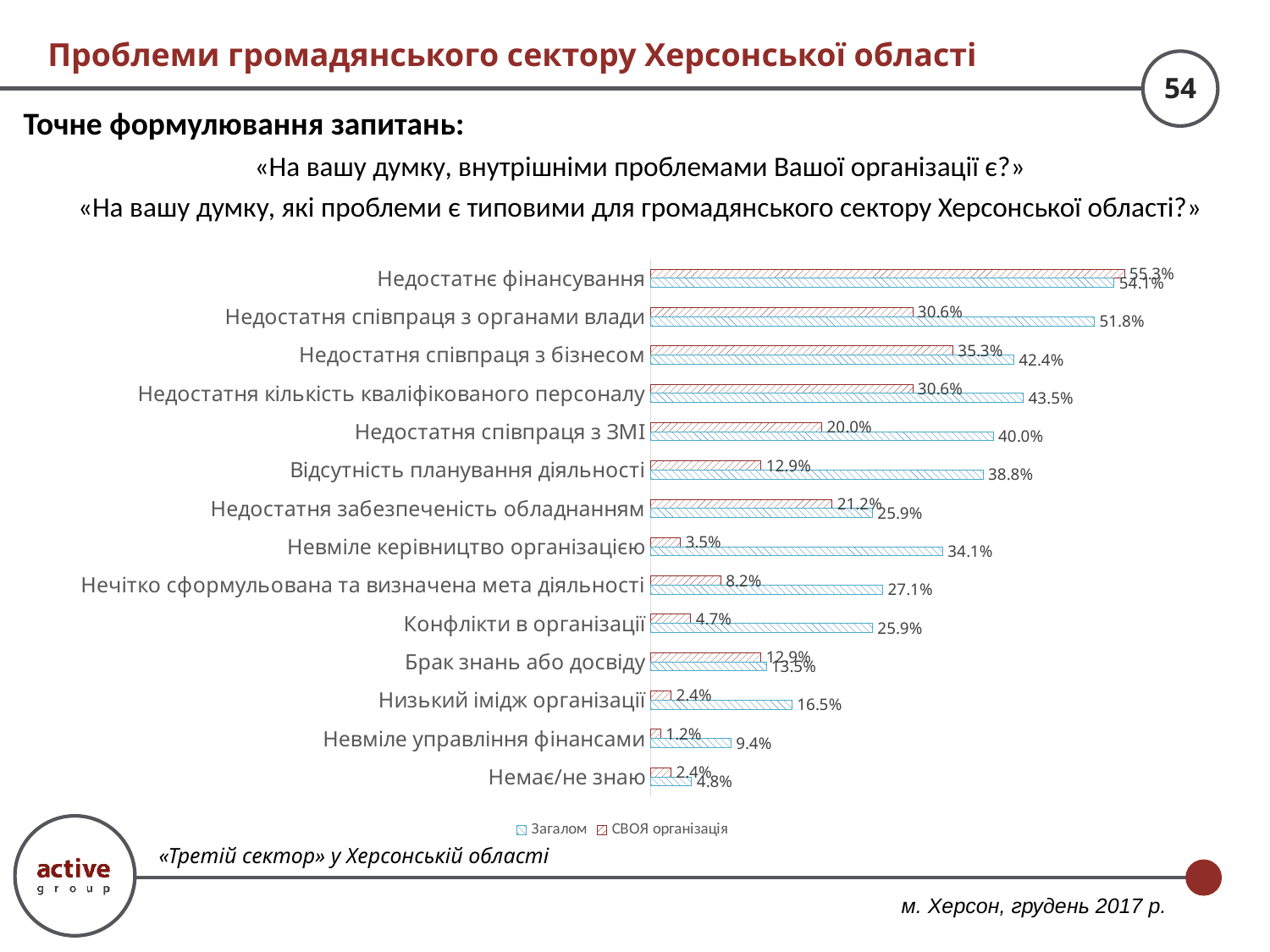
What is the difference between the 'Загалом' and 'СВОЯ організація' values for 'Недостатня співпраця з ЗМІ'? 20.0% What are the two series named in the chart legend? Загалом and СВОЯ організація What type of chart is shown on the slide? bar chart Which category has the lowest value in the 'Загалом' series? Немає/не знаю How many series does the chart legend list? 2 Which category has the highest value in the 'СВОЯ організація' series? Недостатнє фінансування What is the value of the 'Загалом' series for 'Невміле керівництво організацією'? 34.1% What is the value of the 'СВОЯ організація' series for 'Недостатня співпраця з бізнесом'? 35.3% For 'Відсутність планування діяльності', which series has the larger value: 'Загалом' or 'СВОЯ організація'? Загалом How many categories (problems) are plotted in the chart? 14 What is the value of the 'СВОЯ організація' series for 'Невміле управління фінансами'? 1.2% What is the value of the 'Загалом' series for 'Недостатня співпраця з органами влади'? 51.8%